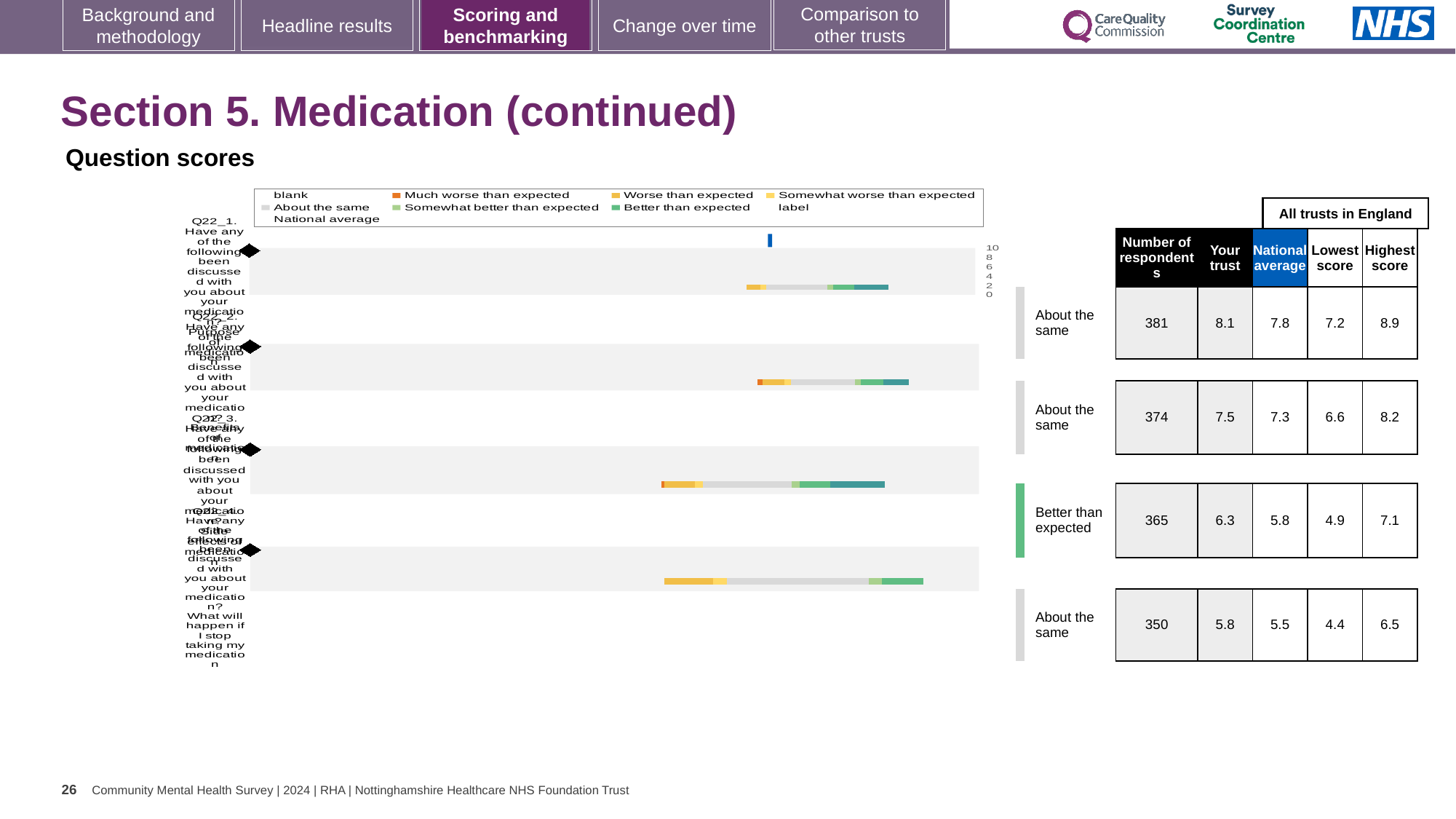
Which question row has the lowest number of respondents in the table? the fourth (bottom) row Which benchmark category is shown for the third question row? Better than expected What is the difference between the 'Your trust' score and the national average for the third question row? 0.5 Which question row has the highest 'Your trust' score in the table? the first (top) row In the table next to the chart, what is the 'Your trust' score for the first (top) question row? 8.1 What kind of chart is shown on the slide under 'Question scores'? bar chart How many question bars are plotted in the chart? 4 In the table next to the chart, what is the highest score for the fourth (bottom) question row? 6.5 Is the 'Your trust' score for the second question row larger than its national average? yes In the table next to the chart, how many respondents are listed for the third question row? 365 In the table next to the chart, what is the national average for the second question row? 7.3 What is the heading above the 'Lowest score' and 'Highest score' columns in the table? All trusts in England